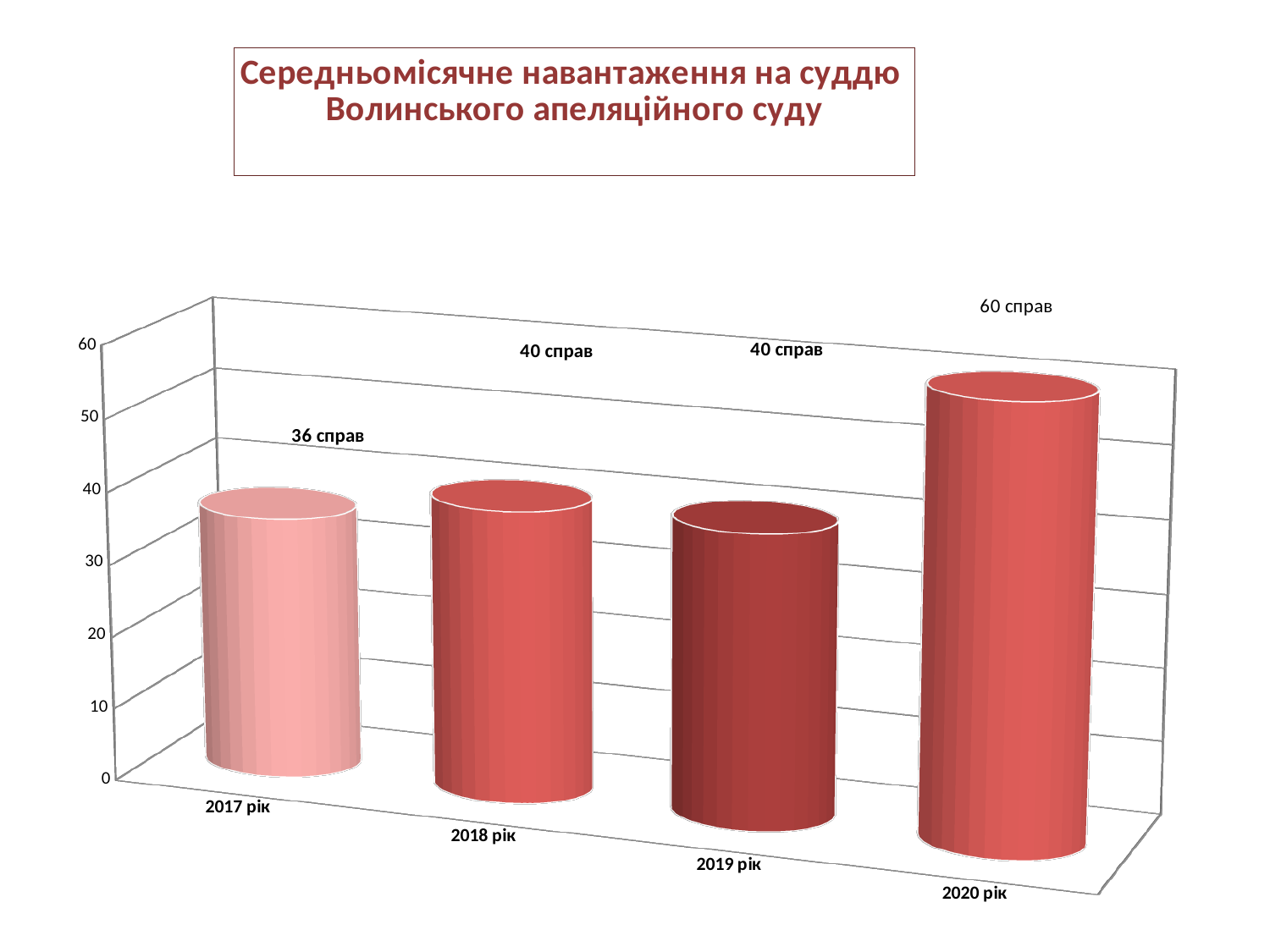
How many years are shown on the chart? 4 What kind of chart is shown on the slide? bar chart Do the values generally rise or fall from 2017 рік to 2020 рік? rise What is the difference between the values for 2018 рік and 2017 рік? 4 справ What is the value shown for 2020 рік? 60 справ Which year has the highest value? 2020 рік Which year has the lowest value? 2017 рік What is the title of the chart? Середньомісячне навантаження на суддю Волинського апеляційного суду What is the difference between the values for 2020 рік and 2017 рік? 24 справ What is the value shown for 2018 рік? 40 справ Which is larger, the value for 2019 рік or the value for 2020 рік? 2020 рік What is the value shown for 2017 рік? 36 справ